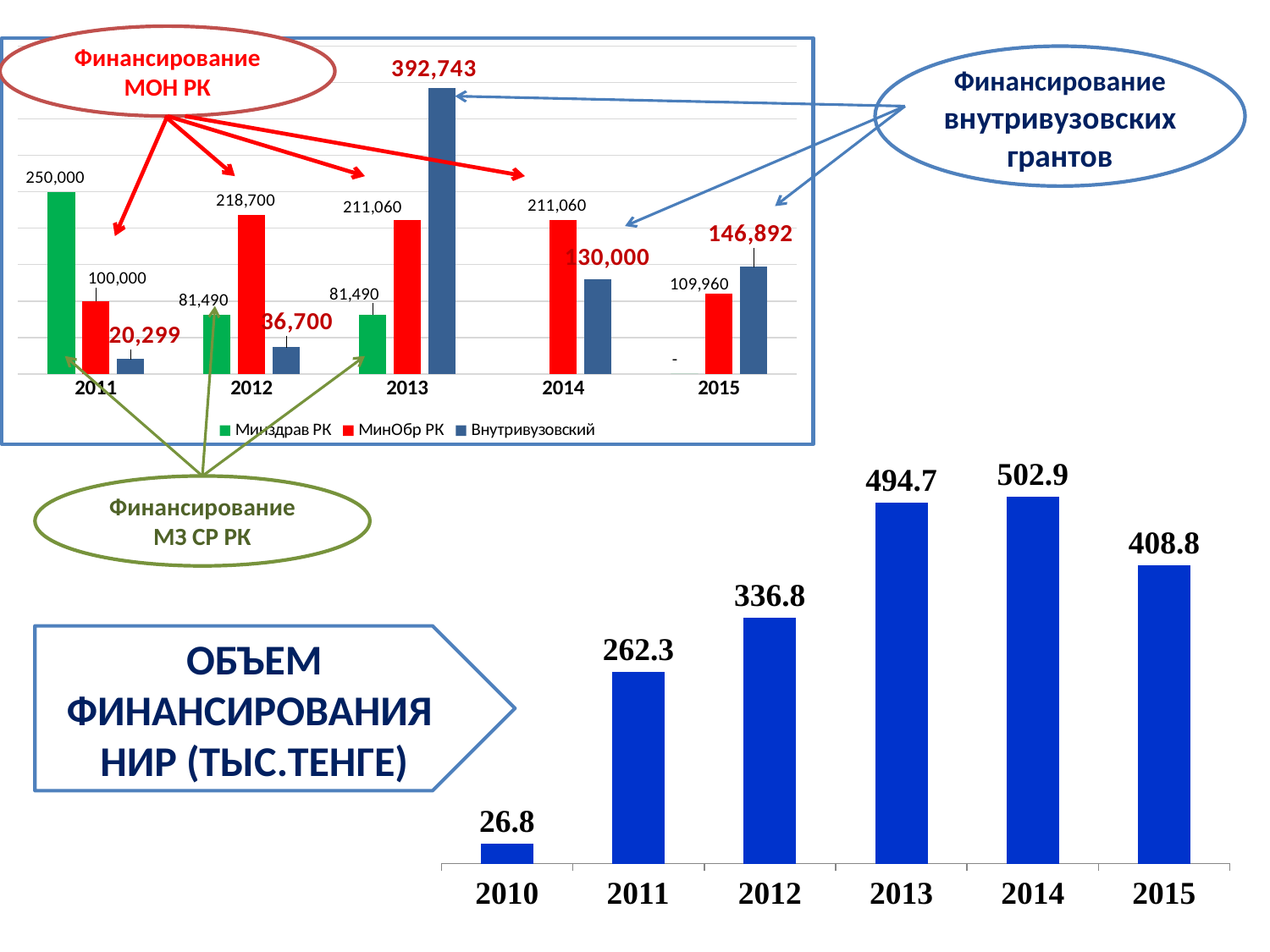
In the top-left chart, what is the difference between МинОбр РК in 2012 and МинОбр РК in 2015? 108,740 What kind of chart is the bottom chart titled ОБЪЕМ ФИНАНСИРОВАНИЯ НИР (ТЫС.ТЕНГЕ)? bar chart In the bottom chart titled ОБЪЕМ ФИНАНСИРОВАНИЯ НИР (ТЫС.ТЕНГЕ), what is the difference between the values for 2014 and 2015? 94.1 In the top-left chart, what is the value for Минздрав РК in 2011? 250,000 In the top-left chart, which is larger in 2012: МинОбр РК or Минздрав РК? МинОбр РК In the bottom chart titled ОБЪЕМ ФИНАНСИРОВАНИЯ НИР (ТЫС.ТЕНГЕ), what is the value for 2013? 494.7 In the bottom chart titled ОБЪЕМ ФИНАНСИРОВАНИЯ НИР (ТЫС.ТЕНГЕ), how many years are shown on the x axis? 6 In the bottom chart titled ОБЪЕМ ФИНАНСИРОВАНИЯ НИР (ТЫС.ТЕНГЕ), do the values rise or fall from 2010 to 2014? rise In the bottom chart titled ОБЪЕМ ФИНАНСИРОВАНИЯ НИР (ТЫС.ТЕНГЕ), which year has the lowest value? 2010 In the bottom chart titled ОБЪЕМ ФИНАНСИРОВАНИЯ НИР (ТЫС.ТЕНГЕ), which year has the highest value? 2014 In the top-left chart, what is the value for Внутривузовский in 2013? 392,743 In the top-left chart, how many series does the legend list? 3